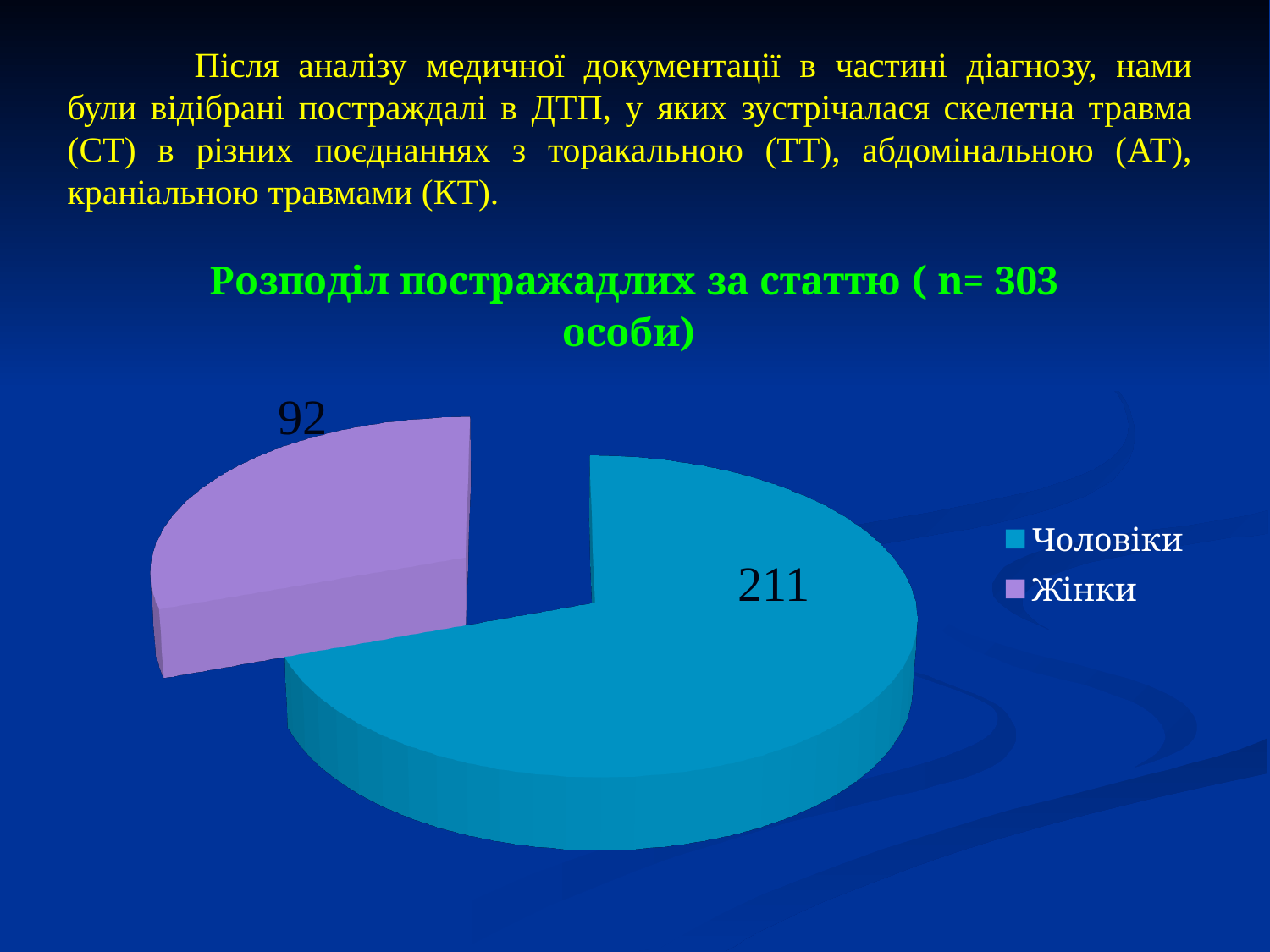
What kind of chart is shown on the slide? Pie chart How many slices does the pie chart have? 2 What is the total of all slices in the pie chart? 303 What is the value for Чоловіки in the pie chart? 211 What is the difference between the values for Чоловіки and Жінки? 119 Which is larger, the value for Чоловіки or the value for Жінки? Чоловіки What share of the pie does the Жінки slice represent? 30.4% How many entries does the legend list? 2 Which category has the smallest slice in the pie chart? Жінки What is the title of the chart? Розподіл постражадлих за статтю ( n= 303 особи) Which category has the largest slice in the pie chart? Чоловіки What is the value for Жінки in the pie chart? 92